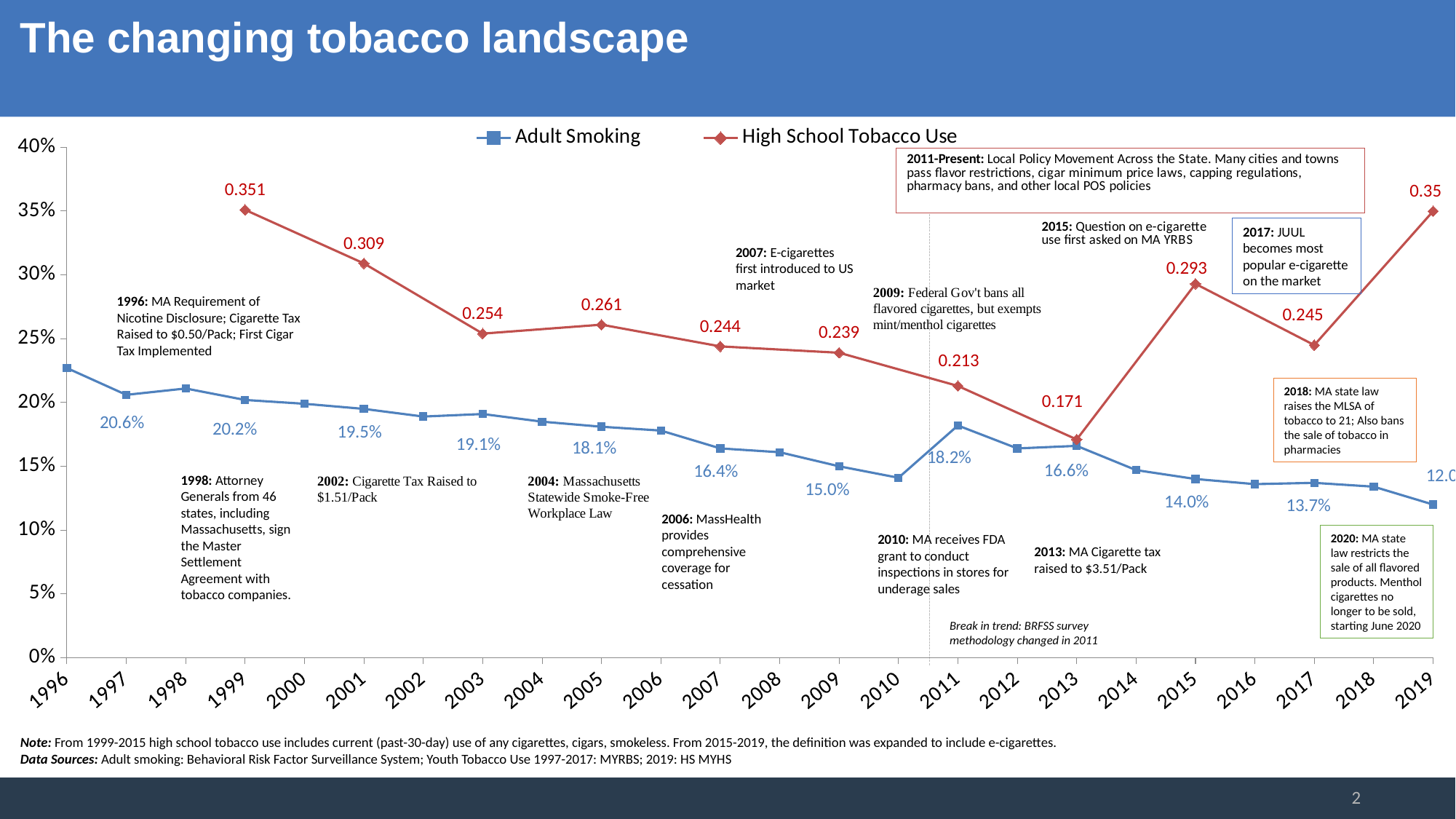
What is the difference between the High School Tobacco Use values for 2015 and 2013? 0.122 What is the Adult Smoking value for 2017? 13.7% How many series does the legend list? 2 What is the High School Tobacco Use value for 2013? 0.171 In which year is the High School Tobacco Use value lowest? 2013 What is the Adult Smoking value for 2007? 16.4% How many years are shown on the x axis? 24 What is the High School Tobacco Use value for 1999? 0.351 Is the Adult Smoking value for 1996 greater or less than 20%? greater Which is larger, the Adult Smoking value for 2009 or for 2011? 2011 Does the Adult Smoking line generally rise or fall from 1996 to 2010? fall What kind of chart is shown on the slide? line chart